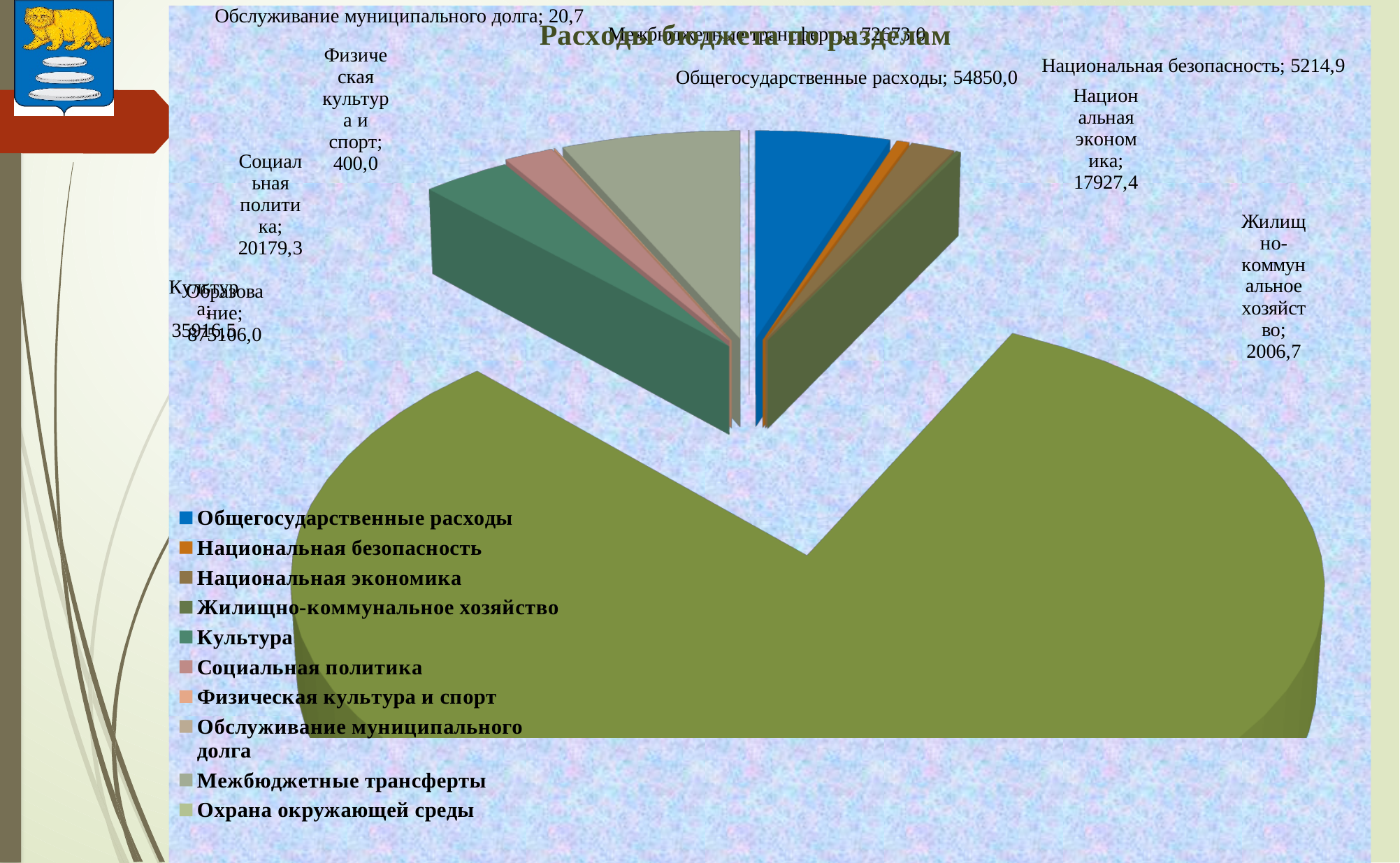
What is the title of the chart? Расходы бюджета по разделам What is the value for Физическая культура и спорт? 400,0 What is the value for Социальная политика? 20179,3 What is the difference between Социальная политика and Национальная экономика? 2251,9 What is the value for Национальная экономика? 17927,4 What is the value for Обслуживание муниципального долга? 20,7 Which is larger, Общегосударственные расходы or Национальная экономика? Общегосударственные расходы What kind of chart is shown on the slide? pie chart What is the value for Жилищно-коммунальное хозяйство? 2006,7 What is the value for Национальная безопасность? 5214,9 What is the value for Общегосударственные расходы? 54850,0 How many entries does the legend list? 10